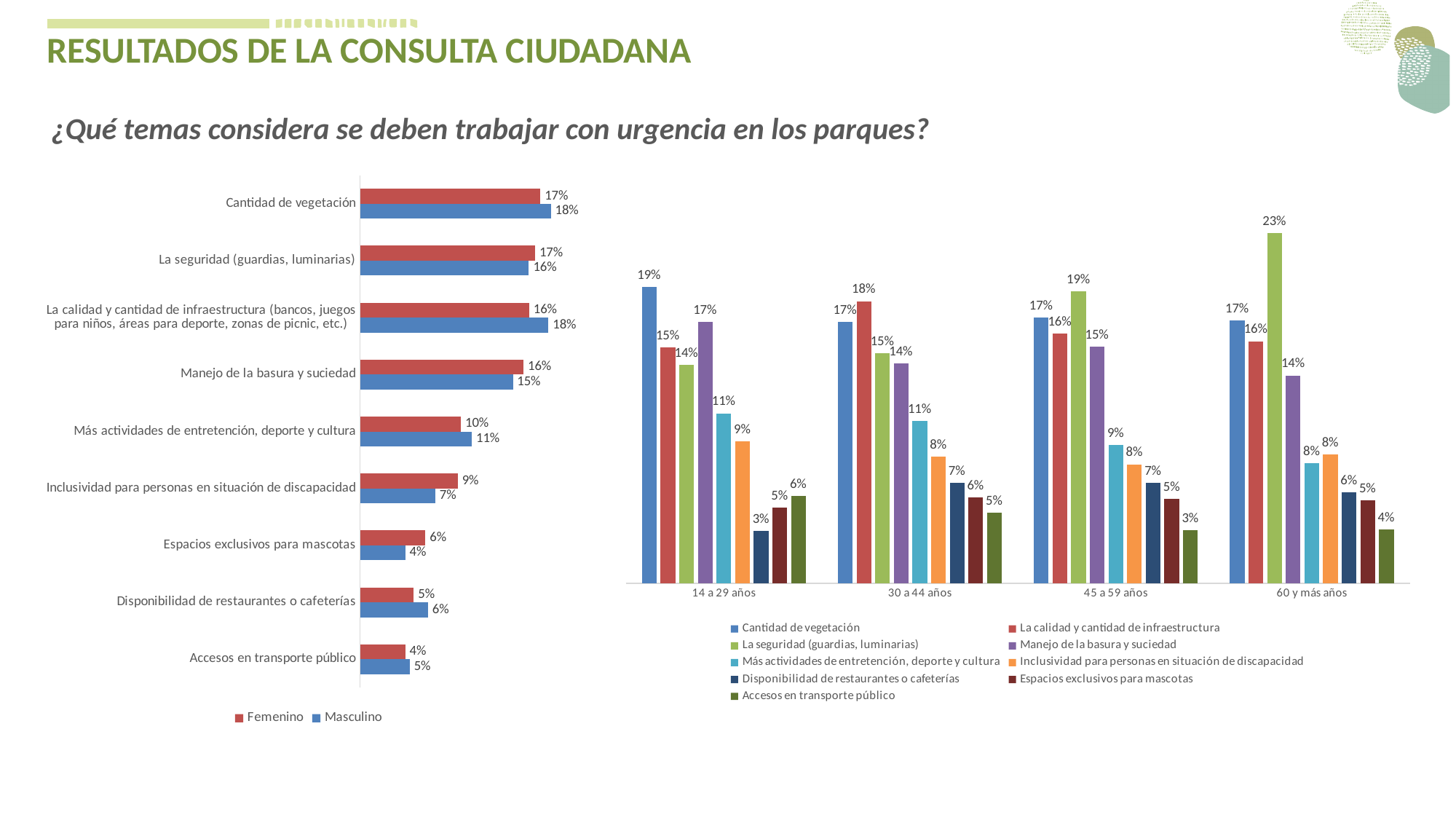
In the left chart (by gender), what is the Femenino value for Inclusividad para personas en situación de discapacidad? 9% In the left chart (by gender), how many categories are shown? 9 In the right chart (by age group), what is the value for Disponibilidad de restaurantes o cafeterías in the 14 a 29 años group? 3% In the left chart (by gender), what is the difference between the Femenino and Masculino values for Espacios exclusivos para mascotas? 2% In the right chart (by age group), which series has the highest value in the 14 a 29 años group? Cantidad de vegetación What kind of chart is the chart on the right (by age group)? Bar chart In the right chart (by age group), how many series does the legend list? 9 In the right chart (by age group), which is larger in the 30 a 44 años group: Cantidad de vegetación or La calidad y cantidad de infraestructura? La calidad y cantidad de infraestructura In the right chart (by age group), what is the value for La seguridad (guardias, luminarias) in the 60 y más años group? 23% In the left chart (by gender), which category has the lowest Femenino value? Accesos en transporte público In the left chart (by gender), how many series does the legend list? 2 In the left chart (by gender), what is the Masculino value for Cantidad de vegetación? 18%